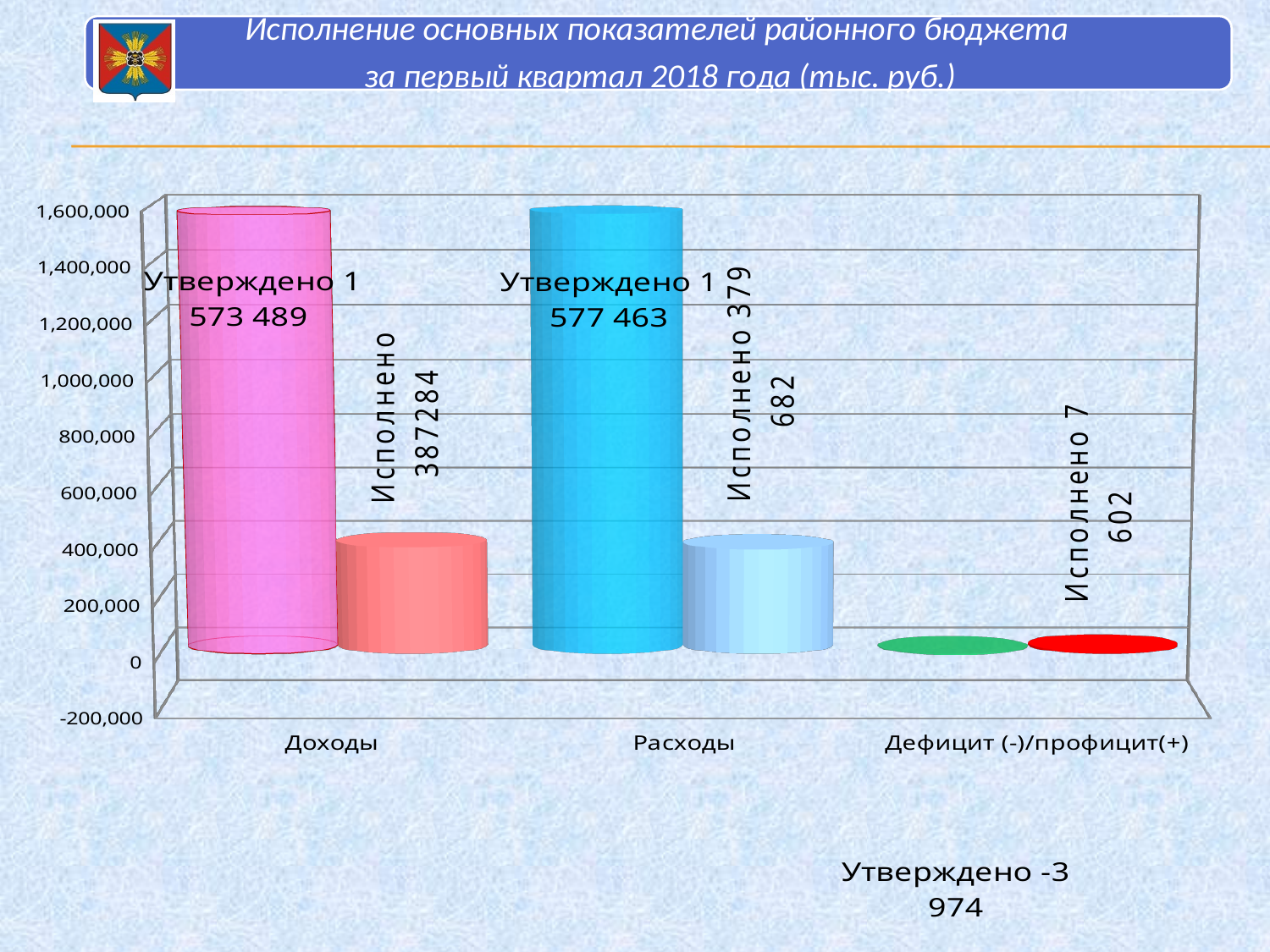
Which category has the higher Исполнено value, Доходы or Расходы? Доходы What is the Исполнено value for Доходы? 387 284 What is the Утверждено value for Доходы? 1 573 489 What is the Исполнено value for Расходы? 379 682 By how much does the Утверждено value for Расходы exceed the Утверждено value for Доходы? 3 974 What is the Утверждено value for Дефицит (-)/профицит(+)? -3 974 Is the Исполнено value for Доходы greater or less than 400,000? less What kind of chart is shown on the slide? bar chart How many categories are shown on the x axis of the chart? 3 What is the Исполнено value for Дефицит (-)/профицит(+)? 7 602 What is the difference between the Исполнено values for Доходы and Расходы? 7 602 What is the Утверждено value for Расходы? 1 577 463